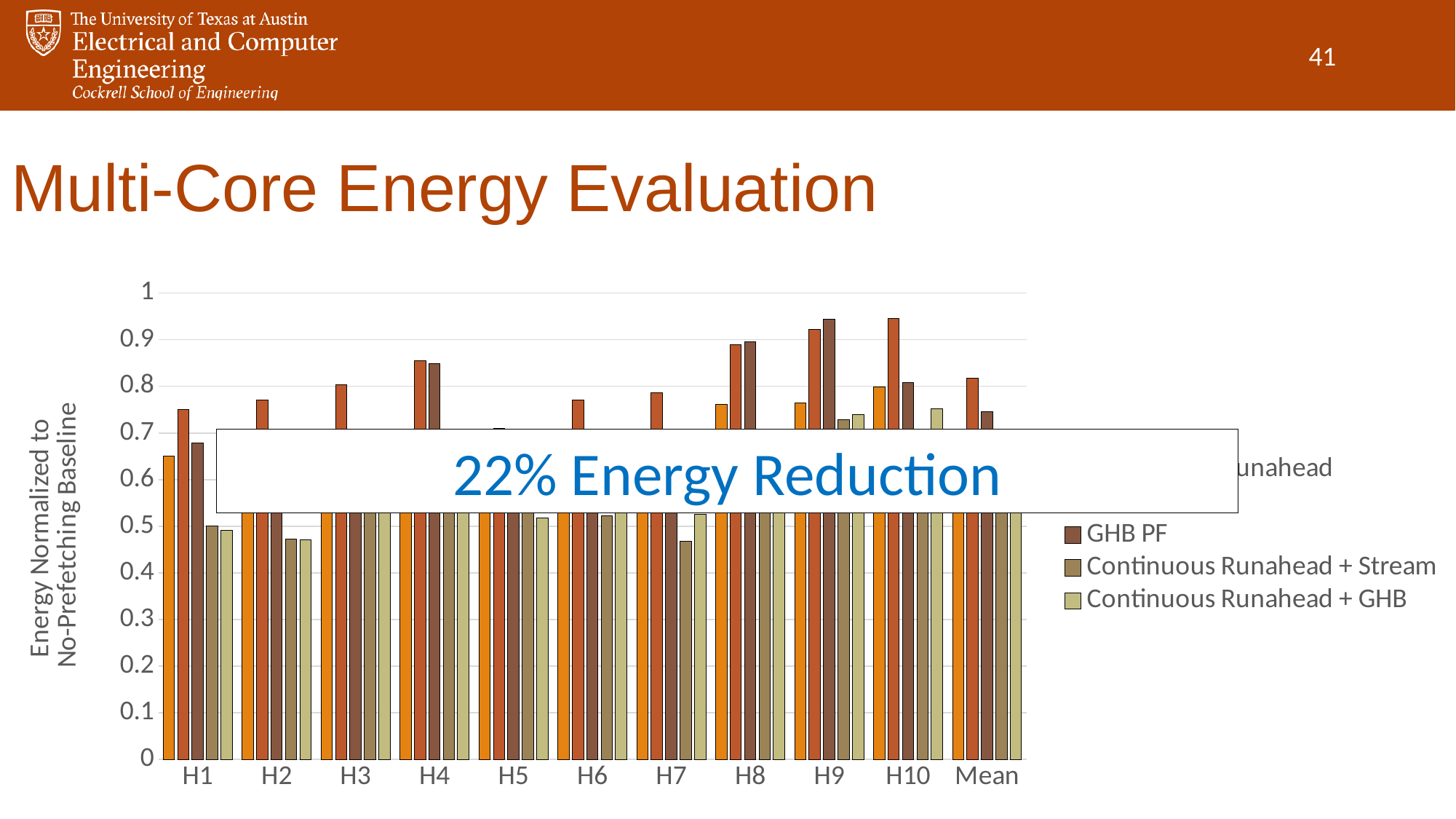
Is the GHB PF value for H9 greater or less than 0.9? greater What kind of chart is shown on the slide? bar chart Is the GHB PF value for H10 greater or less than 0.7? greater For H8, which is larger, the GHB PF value or the Continuous Runahead + GHB value? GHB PF What text is written in the box overlaid on the chart? 22% Energy Reduction Is the Continuous Runahead + Stream value for H9 greater or less than 0.8? less What is the label of the vertical axis of the chart? Energy Normalized to No-Prefetching Baseline How many categories are shown along the x axis of the chart? 11 Which has the larger GHB PF value, H9 or H1? H9